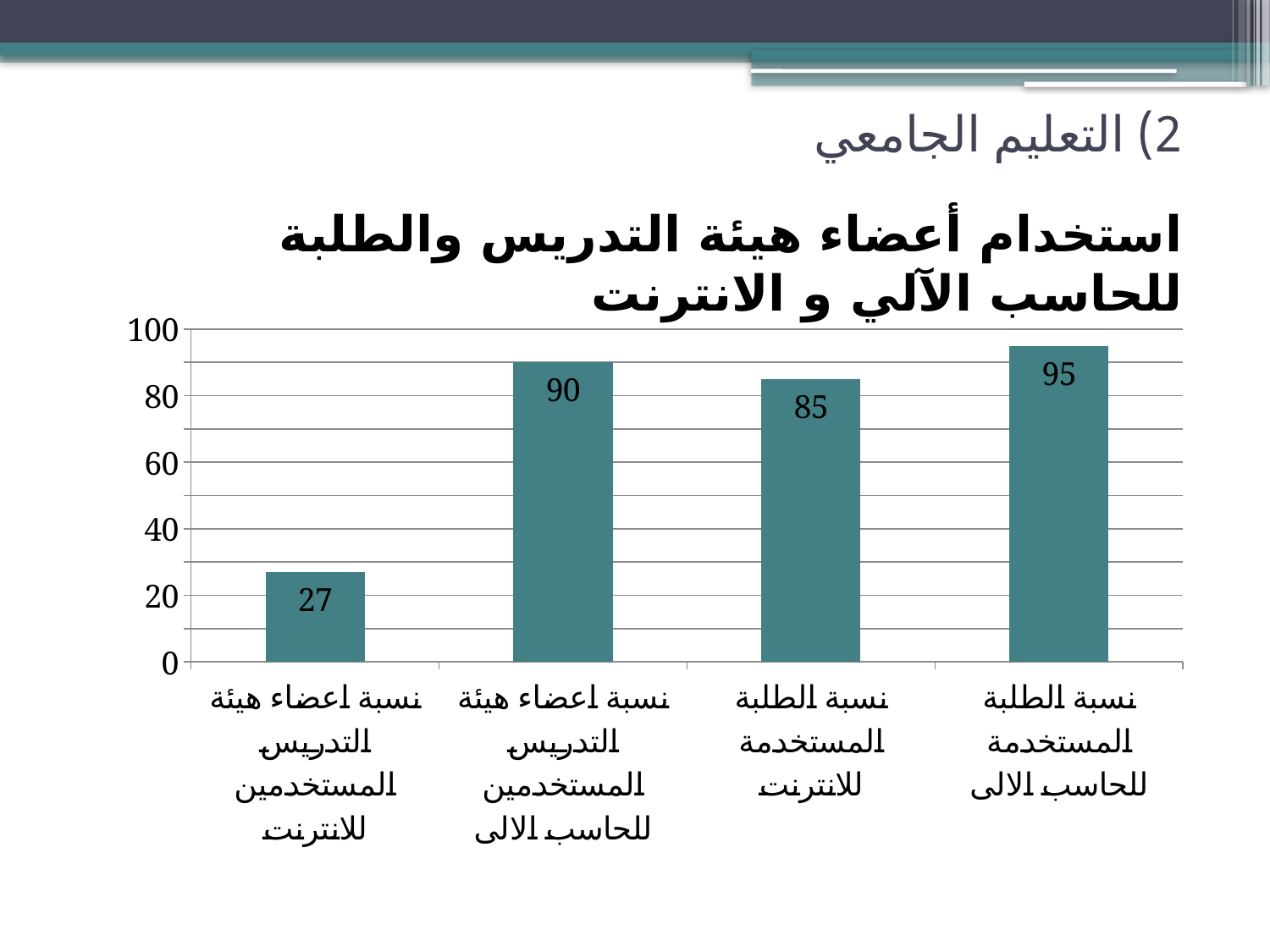
How many categories are shown in the chart? 4 What is the title of the chart? استخدام أعضاء هيئة التدريس والطلبة للحاسب الآلي و الانترنت What is the value for نسبة اعضاء هيئة التدريس المستخدمين للحاسب الالى? 90 What is the difference between the values for نسبة الطلبة المستخدمة للحاسب الالى and نسبة اعضاء هيئة التدريس المستخدمين للانترنت? 68 Which category has the lowest value? نسبة اعضاء هيئة التدريس المستخدمين للانترنت What kind of chart is shown on the slide? bar chart Which is larger: the value for نسبة اعضاء هيئة التدريس المستخدمين للحاسب الالى or the value for نسبة الطلبة المستخدمة للانترنت? نسبة اعضاء هيئة التدريس المستخدمين للحاسب الالى What is the value for نسبة اعضاء هيئة التدريس المستخدمين للانترنت? 27 What is the value for نسبة الطلبة المستخدمة للانترنت? 85 Is the value for نسبة اعضاء هيئة التدريس المستخدمين للانترنت greater or less than 40? less What is the value for نسبة الطلبة المستخدمة للحاسب الالى? 95 Which category has the highest value? نسبة الطلبة المستخدمة للحاسب الالى